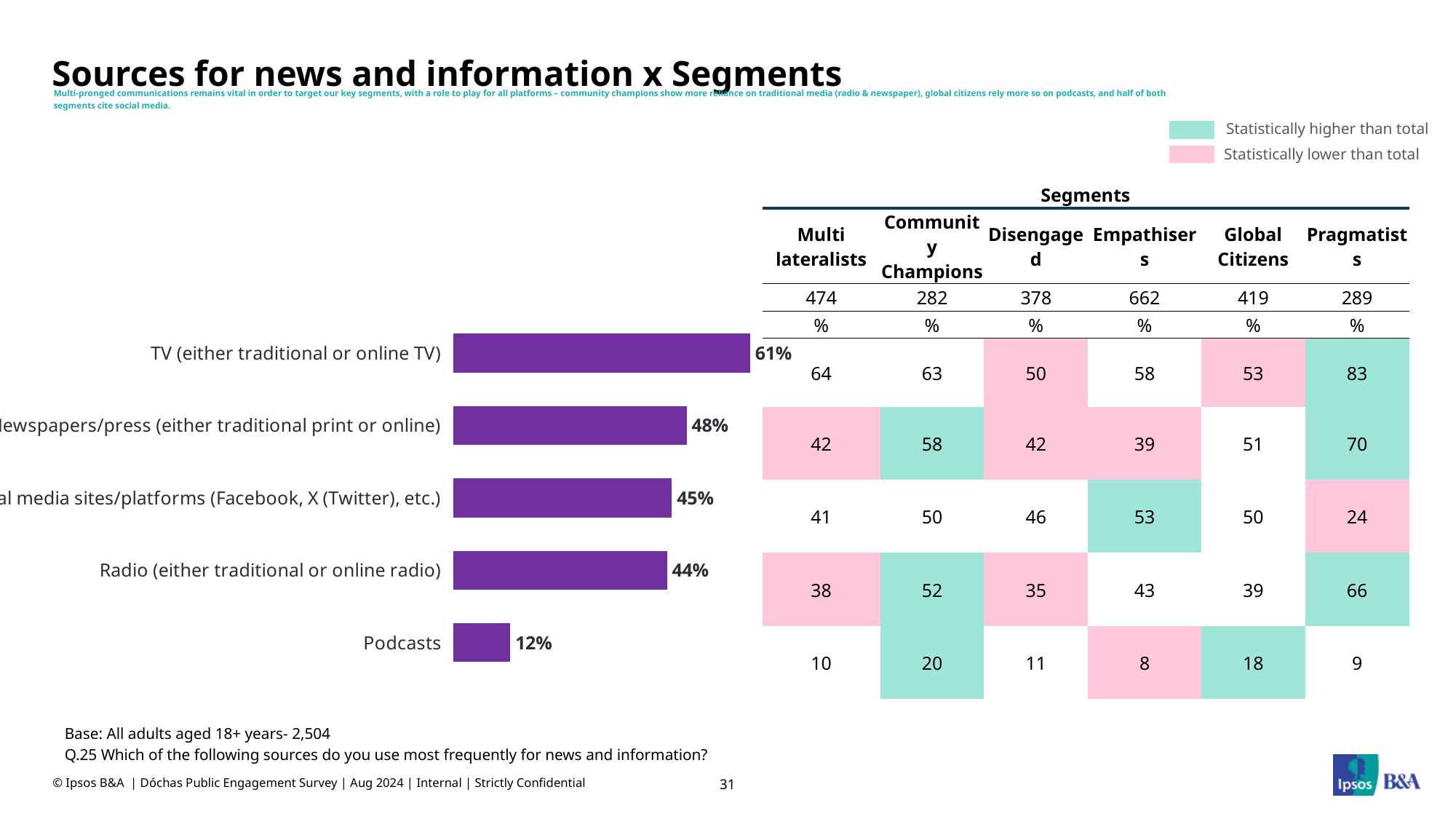
What is the title of the slide containing the chart? Sources for news and information x Segments How many news sources are shown as bars in the chart? 5 What percentage is shown for Radio (either traditional or online radio)? 44% Which news source has the highest percentage in the bar chart? TV (either traditional or online TV) What type of chart is used to show the sources for news and information? Bar chart What is the difference in percentage points between Newspapers/press and Radio? 4 What is the value shown for social media sites/platforms (Facebook, X (Twitter), etc.)? 45% Which news source has the lowest percentage in the bar chart? Podcasts What is the value shown for Podcasts in the bar chart? 12% What is the difference in percentage points between TV and Podcasts? 49 Which has a higher value, Newspapers/press or Radio? Newspapers/press (either traditional print or online) What percentage of respondents cite TV (either traditional or online TV) as a source for news and information? 61%